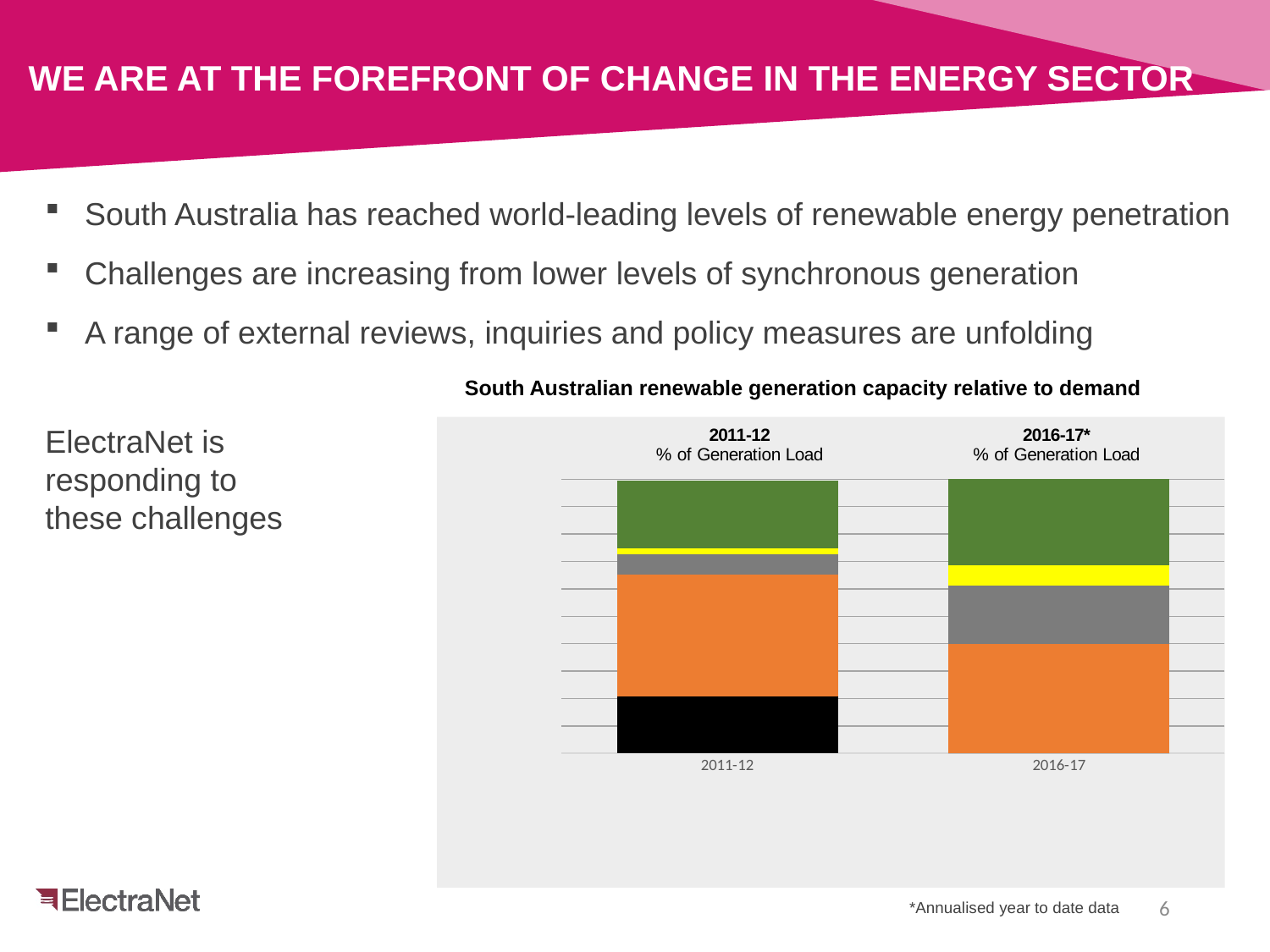
How many categories (bars) does the chart show? 2 Which coloured segment is the largest in the 2011-12 bar? orange What is the title of the chart? South Australian renewable generation capacity relative to demand Which category's bar includes a black segment? 2011-12 Which coloured segment is the smallest in the 2011-12 bar? yellow Is the yellow segment larger in the 2011-12 bar or the 2016-17 bar? 2016-17 Which coloured segment is the smallest in the 2016-17 bar? yellow Is the orange segment larger in the 2011-12 bar or the 2016-17 bar? 2011-12 Is the grey segment larger in the 2011-12 bar or the 2016-17 bar? 2016-17 What kind of chart is shown on the slide? stacked bar chart Which coloured segment is the largest in the 2016-17 bar? orange